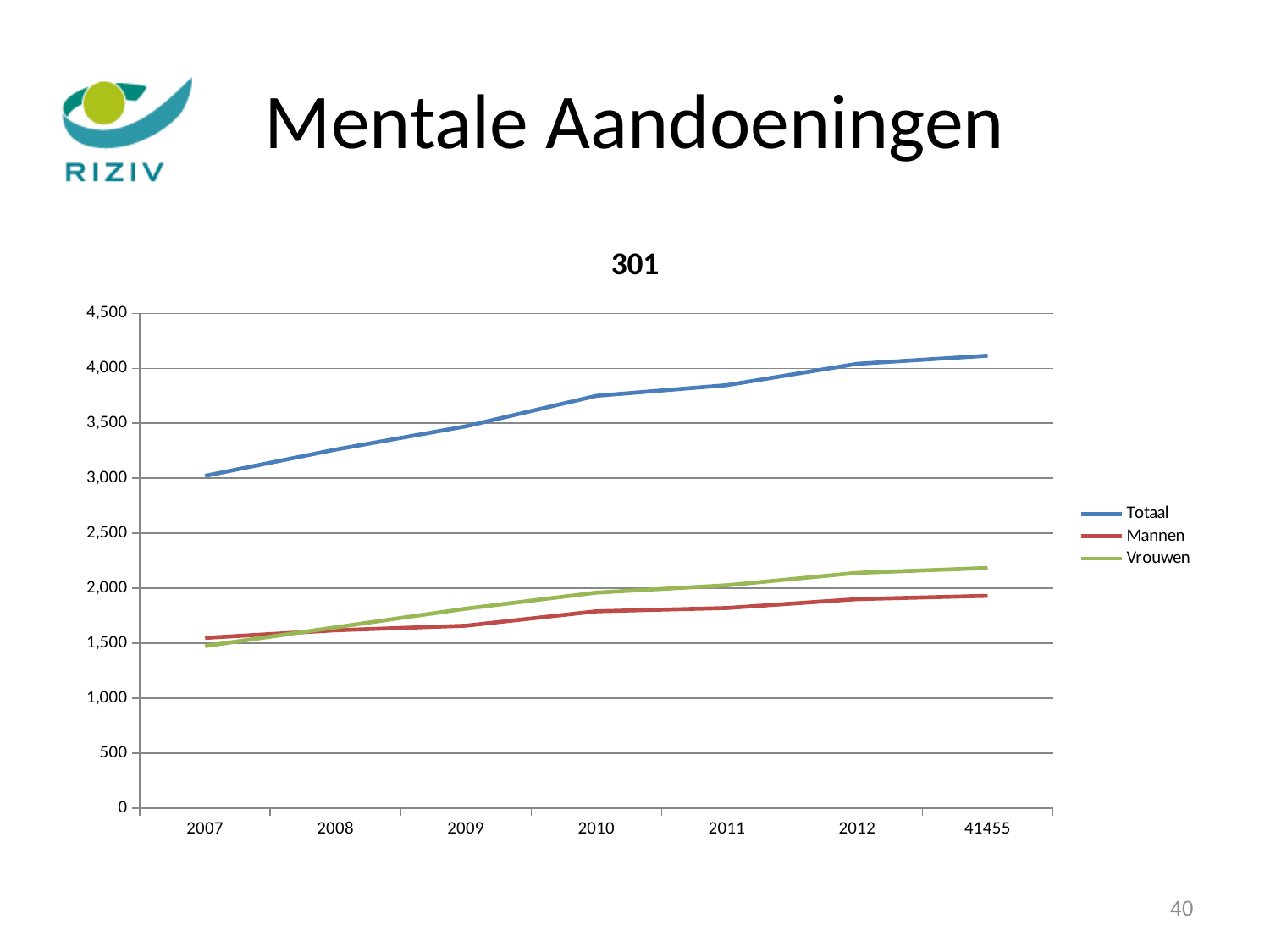
In which year does the Totaal series reach its highest value? 41455 What is the title of the chart? 301 Which series is drawn in blue? Totaal Is the value for Vrouwen in 2012 greater or less than 2,000? greater Does the Totaal series rise or fall from 2007 to the last point? rise Is the value for Mannen at the last point (41455) greater or less than 2,000? less How many series does the legend list? 3 Is the value for Totaal in 2010 greater or less than 3,500? greater What kind of chart is shown on the slide? line chart How many points are plotted along the x axis for each series? 7 In 2012, which is larger, the value for Mannen or the value for Vrouwen? Vrouwen